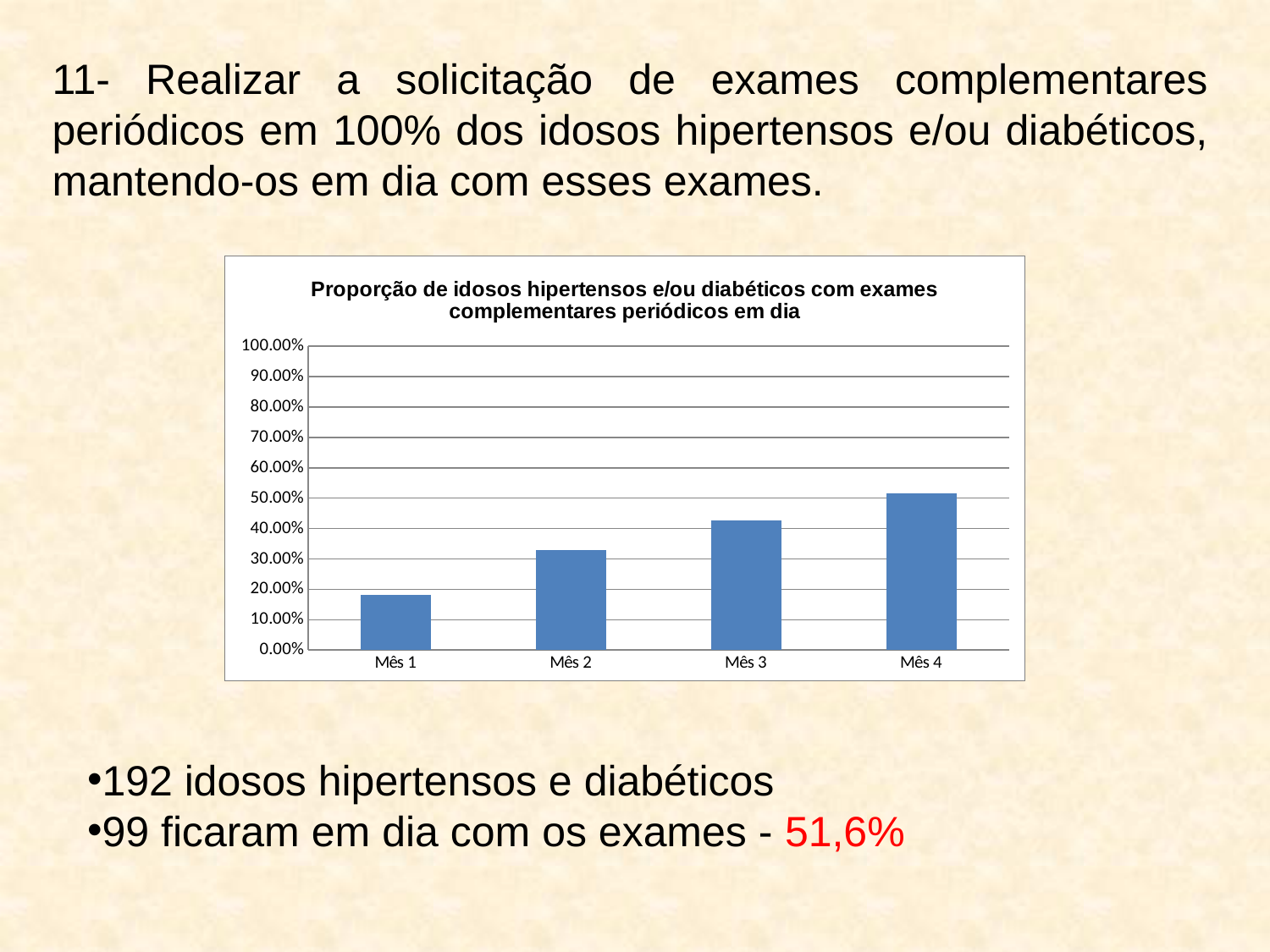
Which is larger, the value for Mês 2 or the value for Mês 3? Mês 3 What is the title of the chart? Proporção de idosos hipertensos e/ou diabéticos com exames complementares periódicos em dia Is the value for Mês 1 greater or less than 20.00%? less How many months (categories) are shown on the x axis of the chart? 4 Which month has the highest proportion in the chart? Mês 4 Which month has the lowest proportion in the chart? Mês 1 What kind of chart is shown on the slide? bar chart Is the value for Mês 2 greater or less than 30.00%? greater Do the values rise or fall from Mês 1 to Mês 4? rise What is the maximum value shown on the y axis of the chart? 100.00% Is the value for Mês 3 greater or less than 50.00%? less